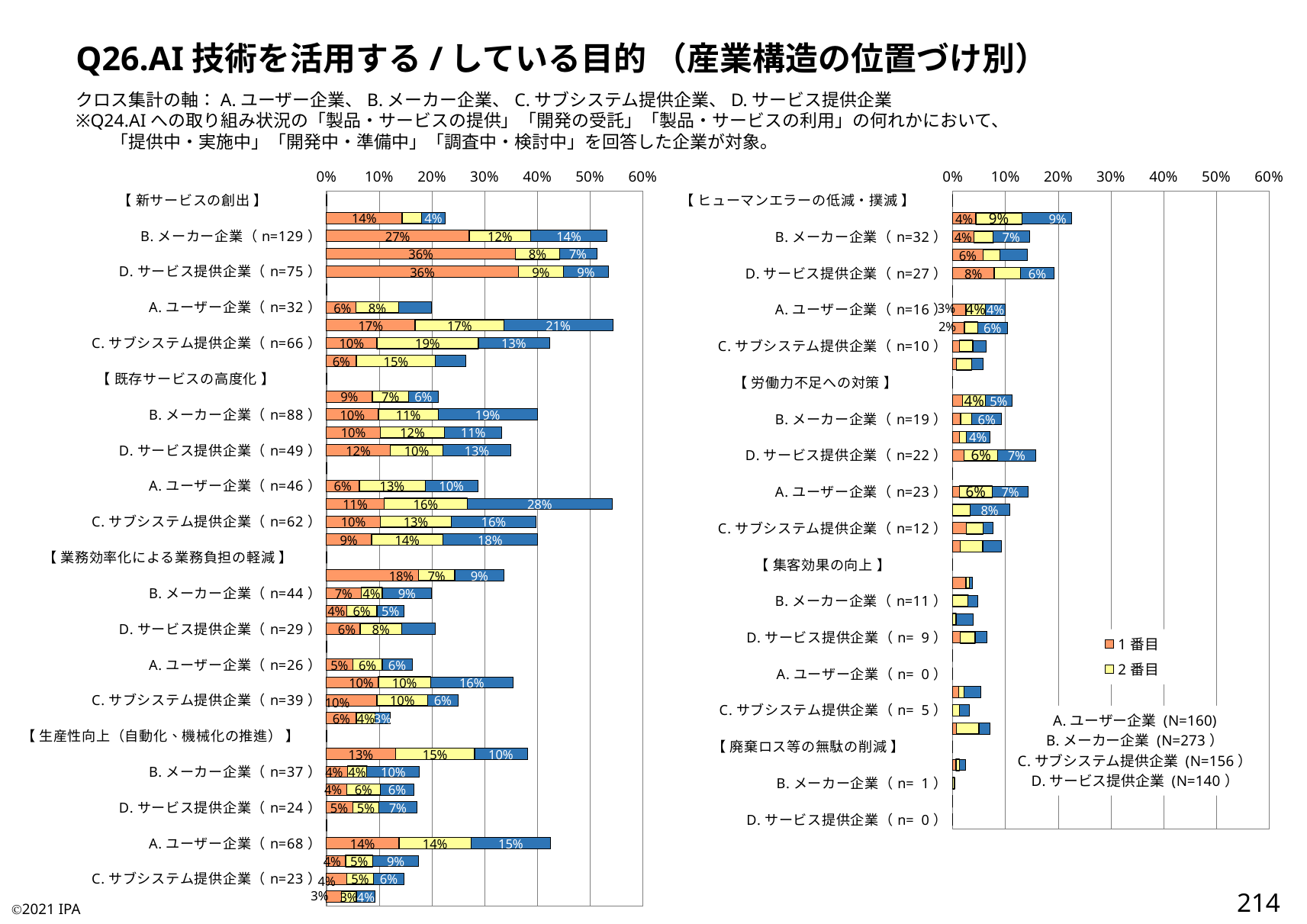
How many purpose headings (in 【 】) are shown in the left chart? 4 According to the note in the right chart, what is N for A. ユーザー企業? N=160 In the left chart, what is the largest 2番目 (yellow) value printed on any bar? 19% In the left chart, what is the largest 1番目 (orange) value printed on any bar? 36% In the left chart, what is the largest blue segment value printed on any bar? 28% What are the two legend entries shown on the slide? 1番目, 2番目 What kind of chart is used on this slide? bar chart How many purpose headings (in 【 】) are shown in the right chart? 4 How many series does the legend list? 2